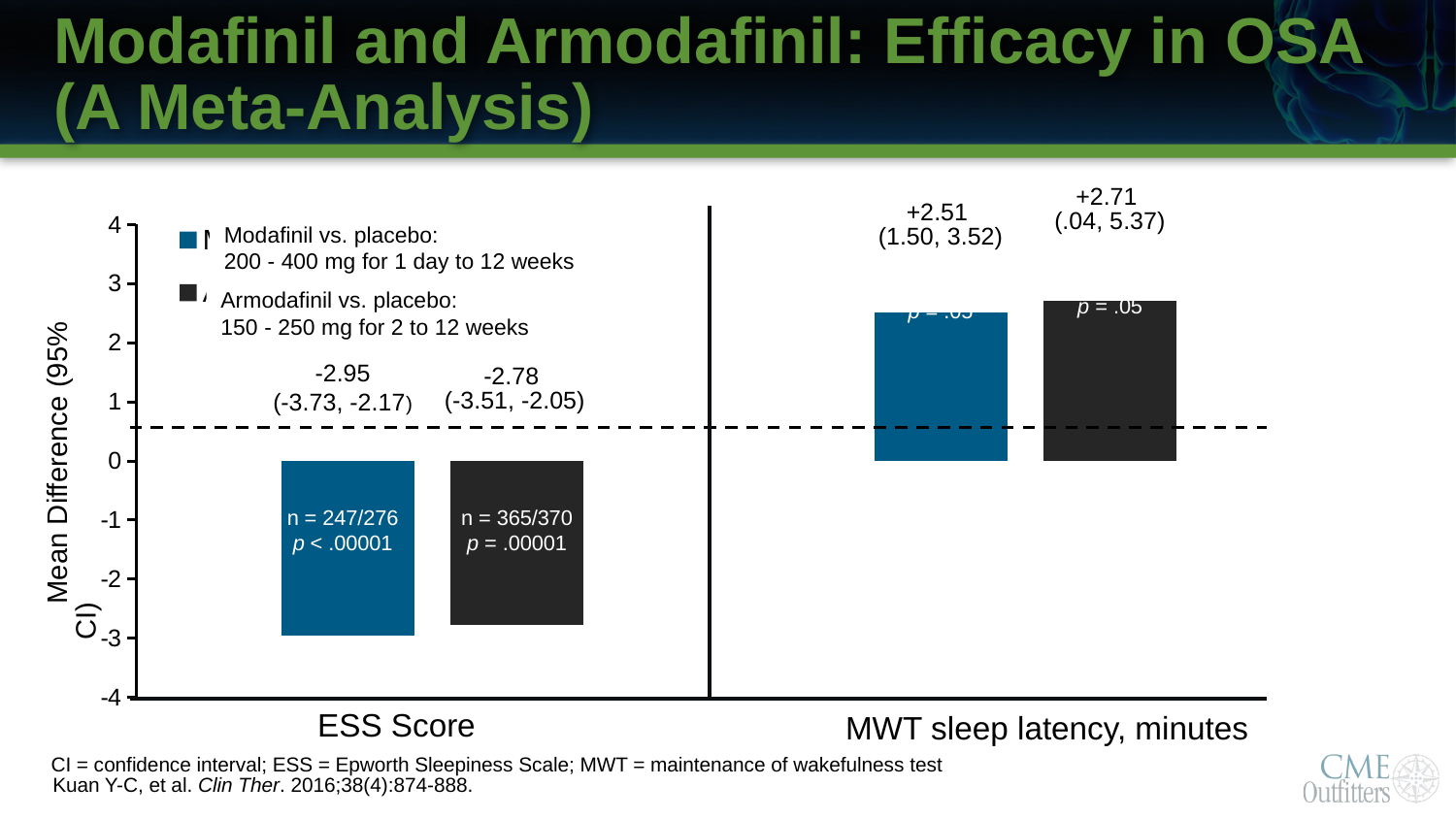
Which drug comparison has the larger mean difference on MWT sleep latency, Modafinil vs. placebo or Armodafinil vs. placebo? Armodafinil vs. placebo What is the 95% confidence interval shown for Modafinil vs. placebo on the ESS Score? (-3.73, -2.17) What is the mean difference for Armodafinil vs. placebo on the ESS Score? -2.78 What is the 95% confidence interval shown for Armodafinil vs. placebo on MWT sleep latency? (.04, 5.37) What is the difference between the ESS Score mean differences for Modafinil vs. placebo (-2.95) and Armodafinil vs. placebo (-2.78)? 0.17 What is the mean difference for Armodafinil vs. placebo on MWT sleep latency, minutes? +2.71 What kind of chart is shown on the slide? Bar chart What is the difference between the MWT mean differences for Armodafinil vs. placebo (+2.71) and Modafinil vs. placebo (+2.51)? 0.20 What is the mean difference for Modafinil vs. placebo on MWT sleep latency, minutes? +2.51 What is the mean difference for Modafinil vs. placebo on the ESS Score? -2.95 How many series does the legend list? 2 What is the label of the y axis? Mean Difference (95% CI)